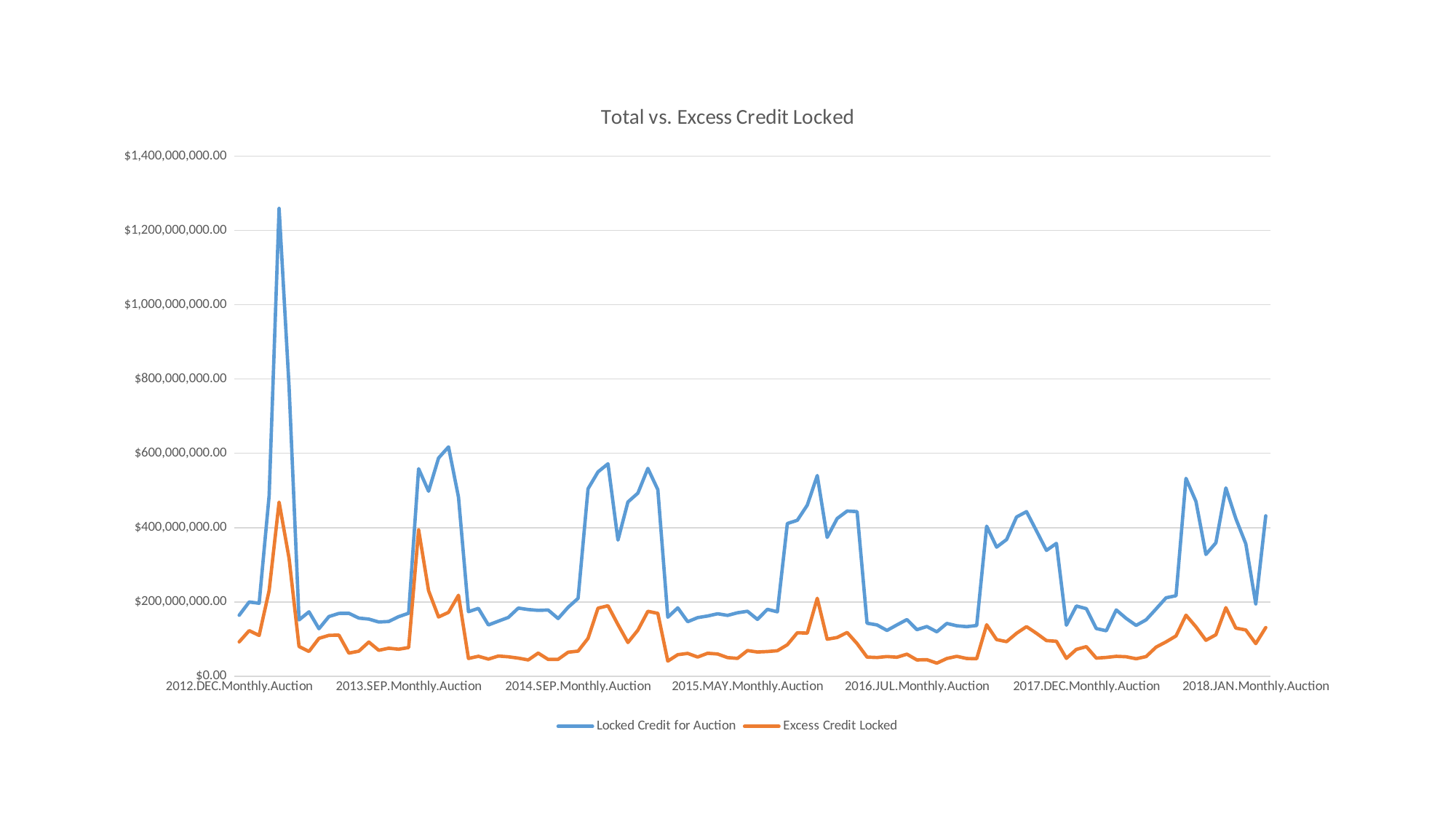
What kind of chart is shown on the slide? line chart How many category labels are shown on the x axis? 7 What is the title of the chart? Total vs. Excess Credit Locked Is the Excess Credit Locked value at 2012.DEC.Monthly.Auction greater or less than $200,000,000.00? less Which series reaches the higher peak, Locked Credit for Auction or Excess Credit Locked? Locked Credit for Auction Is the highest value of the Excess Credit Locked series greater or less than $400,000,000.00? greater Is the highest value of the Excess Credit Locked series greater or less than $600,000,000.00? less How many series does the legend list? 2 Which series has the higher value at 2012.DEC.Monthly.Auction? Locked Credit for Auction Which colour is used for the Excess Credit Locked series? orange